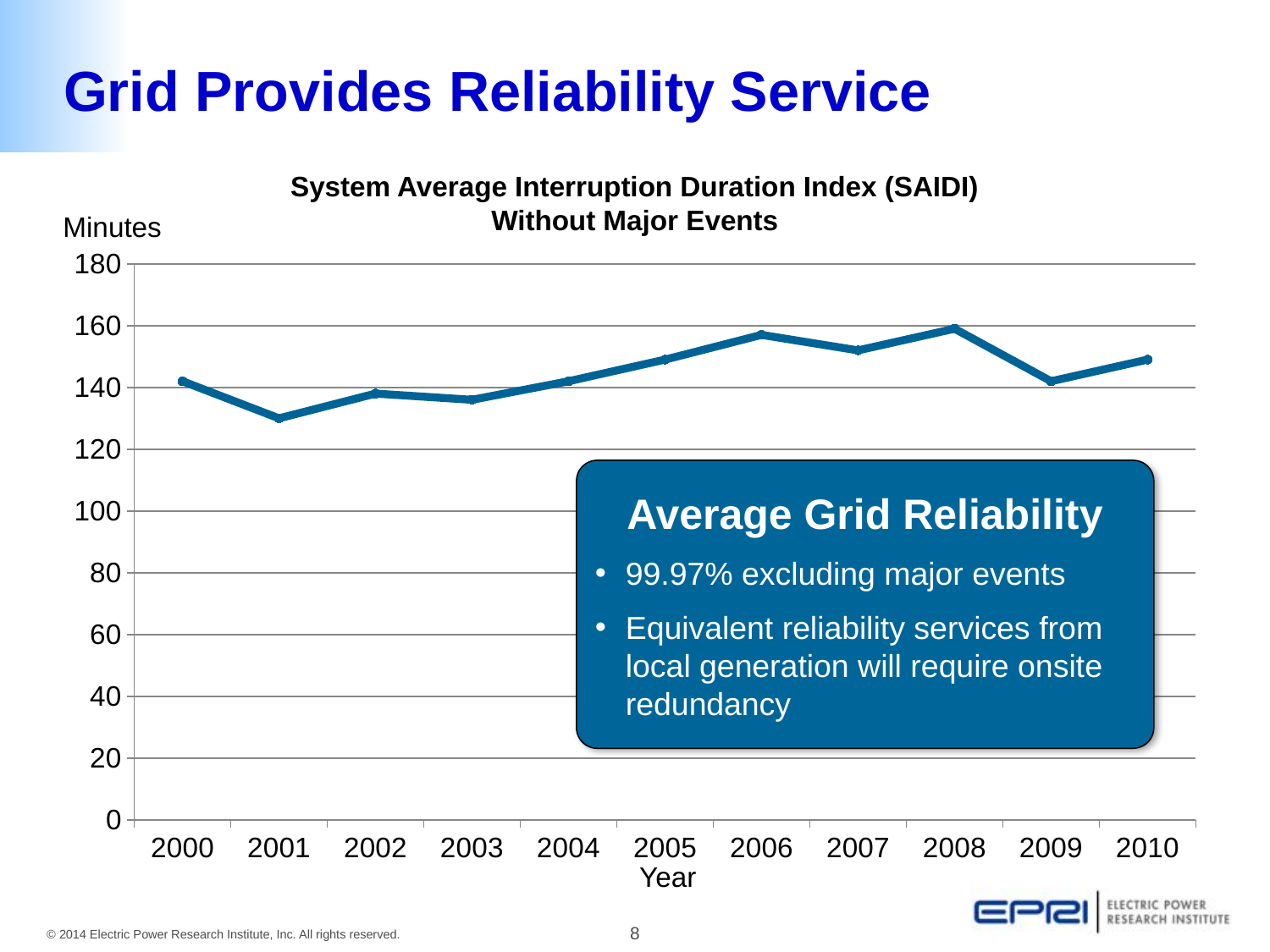
Is the value for 2003 greater or less than 140? less Is the value for 2010 greater or less than 140? greater Which year has the larger SAIDI value, 2003 or 2008? 2008 Is the value for 2006 greater or less than 140? greater What unit is shown on the vertical axis of the chart? Minutes What kind of chart is shown on the slide? line chart Do the values rise or fall from 2003 to 2006? rise Which year has the lowest SAIDI value in the chart? 2001 How many years are plotted on the x axis of the chart? 11 Which year has the larger SAIDI value, 2006 or 2001? 2006